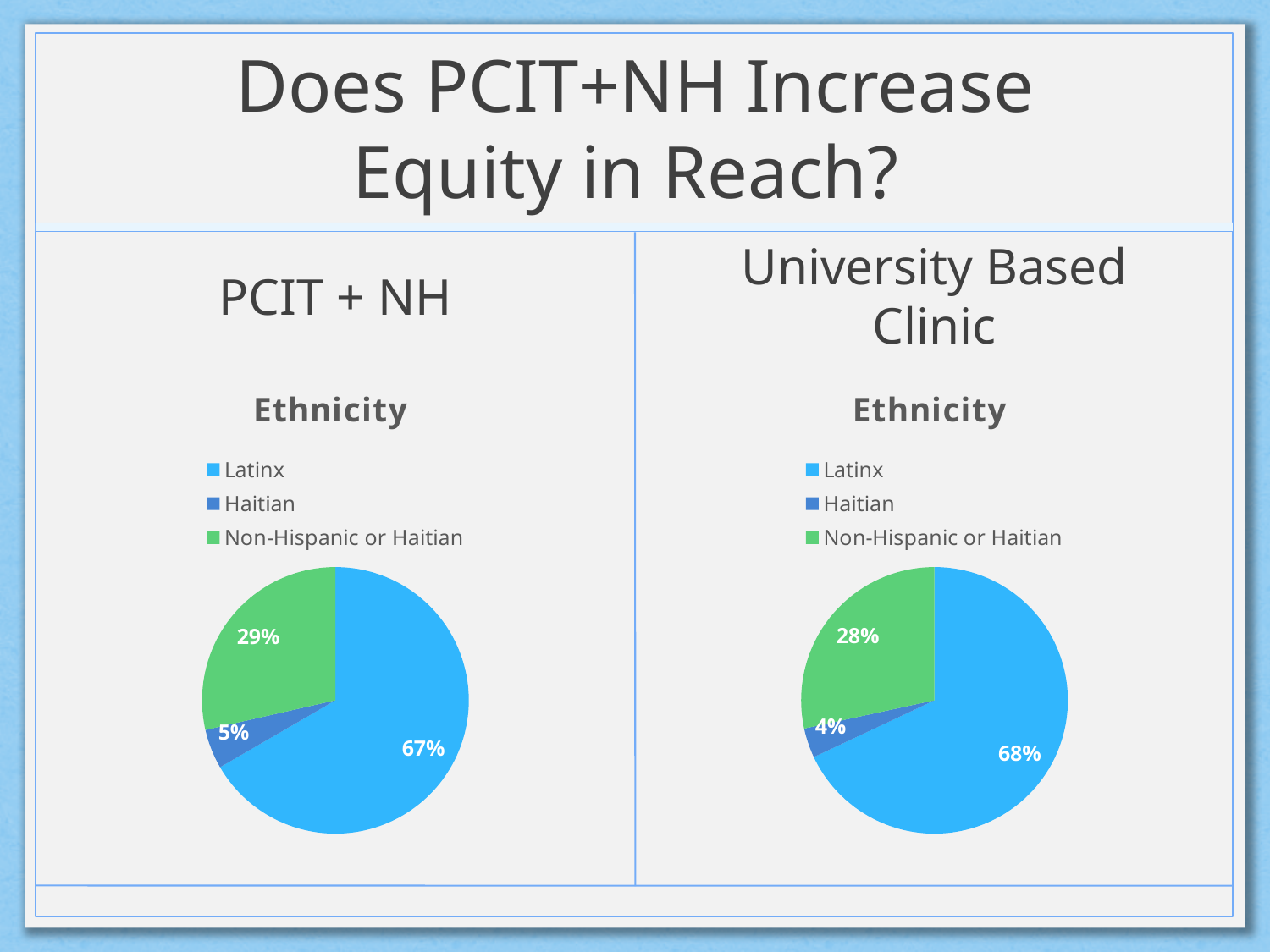
In the University Based Clinic pie chart on the right, what share is Latinx? 68% In the PCIT + NH pie chart on the left, what is the difference between the Latinx and Non-Hispanic or Haitian shares? 38% What is the title of the chart under the University Based Clinic heading on the right? Ethnicity In the University Based Clinic pie chart on the right, what share is Haitian? 4% What type of chart is used under the PCIT + NH heading on the left? Pie chart In the University Based Clinic pie chart on the right, what share is Non-Hispanic or Haitian? 28% In the University Based Clinic pie chart on the right, which category has the smallest slice? Haitian In the PCIT + NH pie chart on the left, what share is Latinx? 67% In the PCIT + NH pie chart on the left, which category has the largest slice? Latinx In the PCIT + NH pie chart on the left, what share is Non-Hispanic or Haitian? 29% How many categories does the legend of the University Based Clinic pie chart on the right list? 3 In the PCIT + NH pie chart on the left, what share is Haitian? 5%